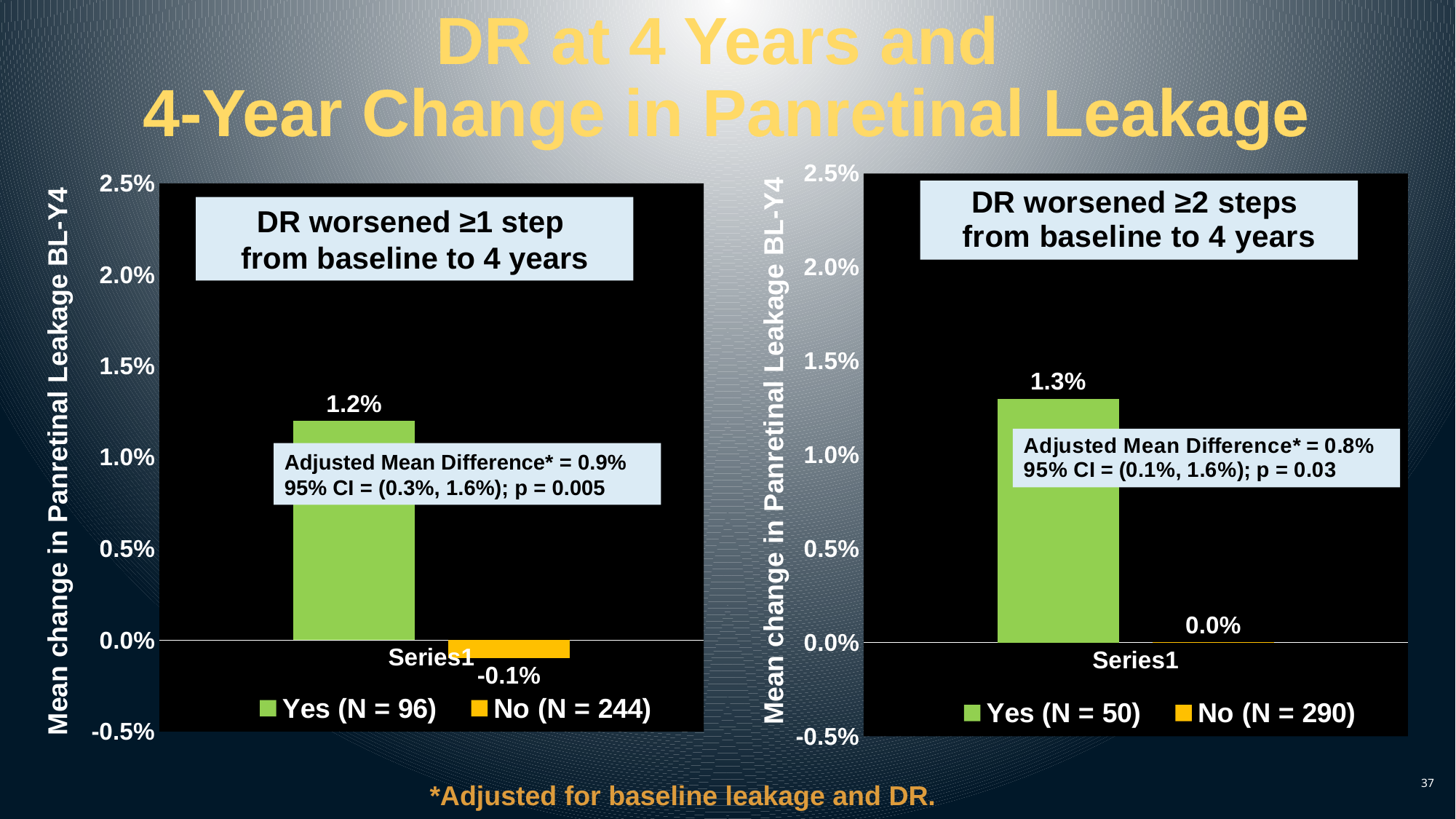
In the left chart (DR worsened ≥1 step), what is the mean change in panretinal leakage for the No (N = 244) group? -0.1% In the left chart (DR worsened ≥1 step), what is the difference between the Yes and No group values? 1.3% In the right chart (DR worsened ≥2 steps), what is the mean change in panretinal leakage for the Yes (N = 50) group? 1.3% How many series does the legend of the left chart (DR worsened ≥1 step) list? 2 In the right chart (DR worsened ≥2 steps), which group has the lower mean change in panretinal leakage? No (N = 290) In the left chart (DR worsened ≥1 step), which group has the higher mean change in panretinal leakage? Yes (N = 96) What kind of chart is the right chart (DR worsened ≥2 steps)? bar chart Is the Yes group value in the right chart (DR worsened ≥2 steps) greater or less than 1.0%? greater In the right chart (DR worsened ≥2 steps), what is the difference between the Yes and No group values? 1.3% In the right chart (DR worsened ≥2 steps), what is the mean change in panretinal leakage for the No (N = 290) group? 0.0% In the left chart (DR worsened ≥1 step), what is the mean change in panretinal leakage for the Yes (N = 96) group? 1.2% In the right chart (DR worsened ≥2 steps), what is the adjusted mean difference shown in the annotation box? 0.8%